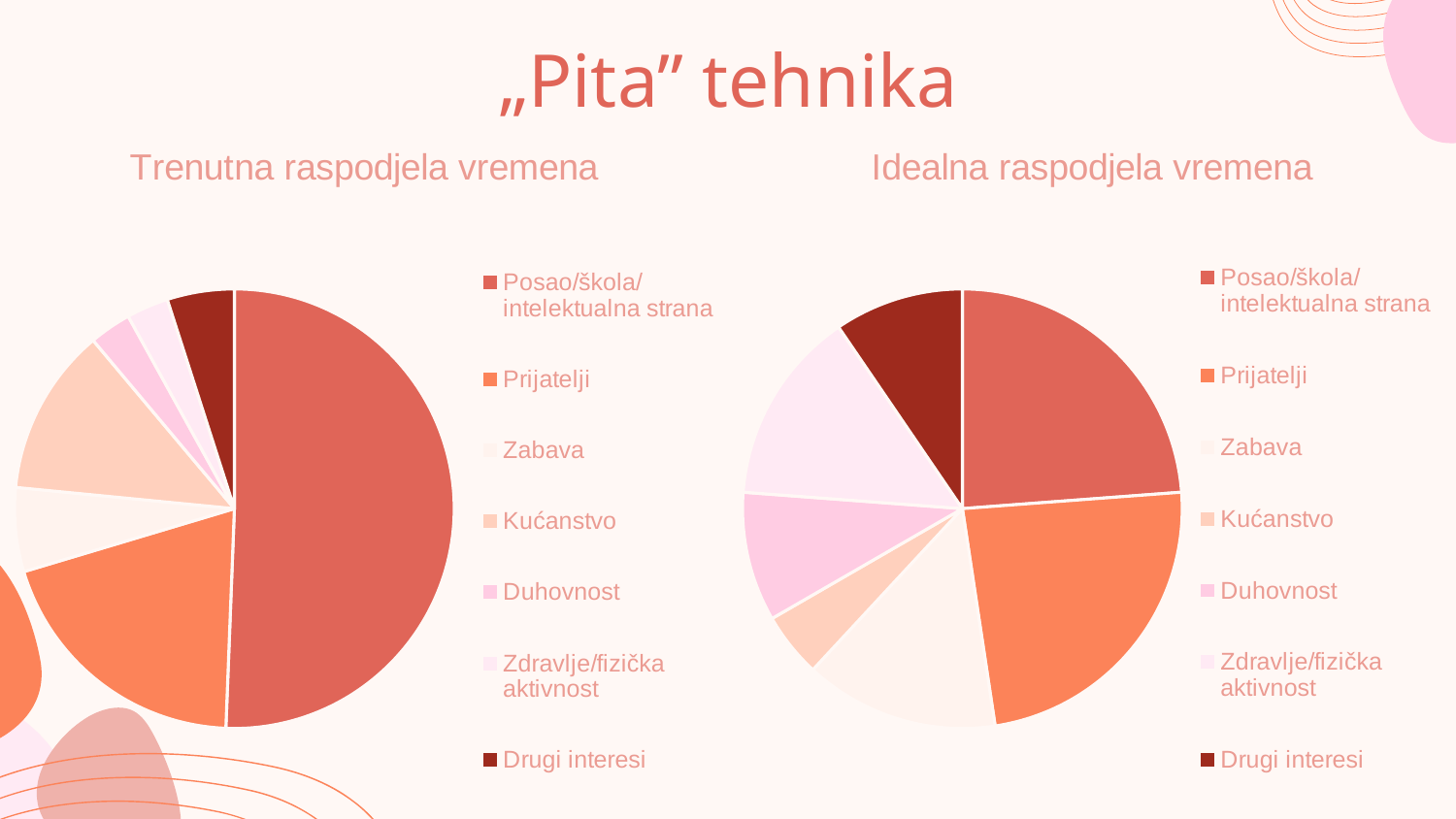
In the "Idealna raspodjela vremena" chart, which slice is larger: Zabava or Duhovnost? Zabava What is the last category listed in the legend of the "Idealna raspodjela vremena" chart? Drugi interesi In the "Trenutna raspodjela vremena" chart, which slice is larger: Posao/škola/intelektualna strana or Prijatelji? Posao/škola/intelektualna strana What is the title of the pie chart on the left side of the slide? Trenutna raspodjela vremena In the "Trenutna raspodjela vremena" chart, how many categories does the legend list? 7 In the "Trenutna raspodjela vremena" chart, which category has the largest slice? Posao/škola/intelektualna strana What kind of chart is used on the right side of the slide, under "Idealna raspodjela vremena"? pie chart What kind of chart is used on the left side of the slide, under "Trenutna raspodjela vremena"? pie chart In the "Idealna raspodjela vremena" chart, which slice is larger: Zdravlje/fizička aktivnost or Drugi interesi? Zdravlje/fizička aktivnost In the "Idealna raspodjela vremena" chart, how many slices are there? 7